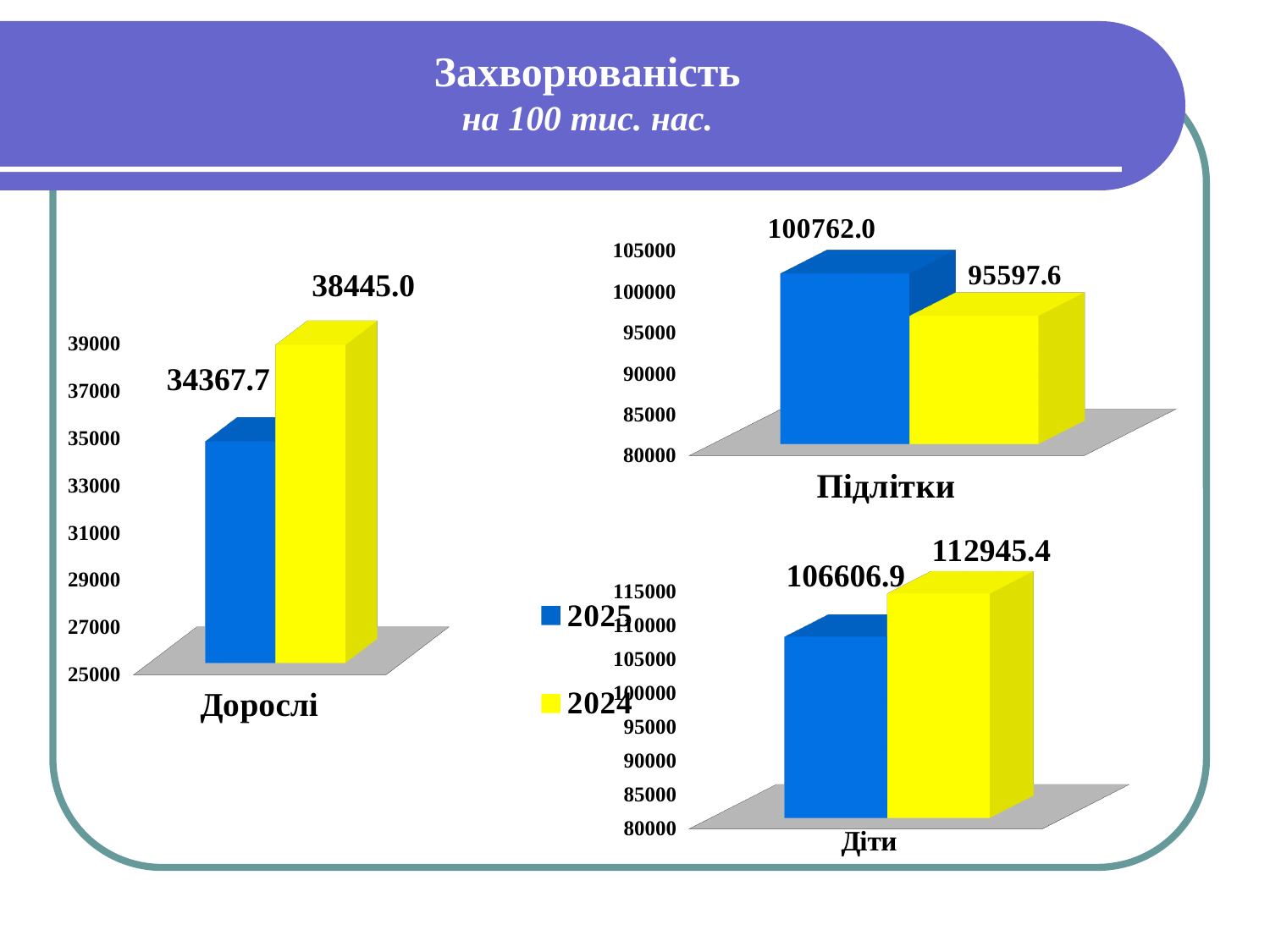
In the Дорослі chart, which year has the higher value, 2025 or 2024? 2024 In the Дорослі chart, what is the value for 2025? 34367.7 In the Підлітки chart, what is the value for 2025? 100762.0 What type of chart is the Підлітки chart? Bar chart In the Підлітки chart, which year has the higher value, 2025 or 2024? 2025 In the Дорослі chart, what is the difference between the 2024 and 2025 values? 4077.3 In the Діти chart, what is the difference between the 2024 and 2025 values? 6338.5 How many series does the legend list? 2 In the Діти chart, what is the value for 2025? 106606.9 In the Діти chart, what is the value for 2024? 112945.4 In the Підлітки chart, what is the value for 2024? 95597.6 In the Дорослі chart, what is the value for 2024? 38445.0